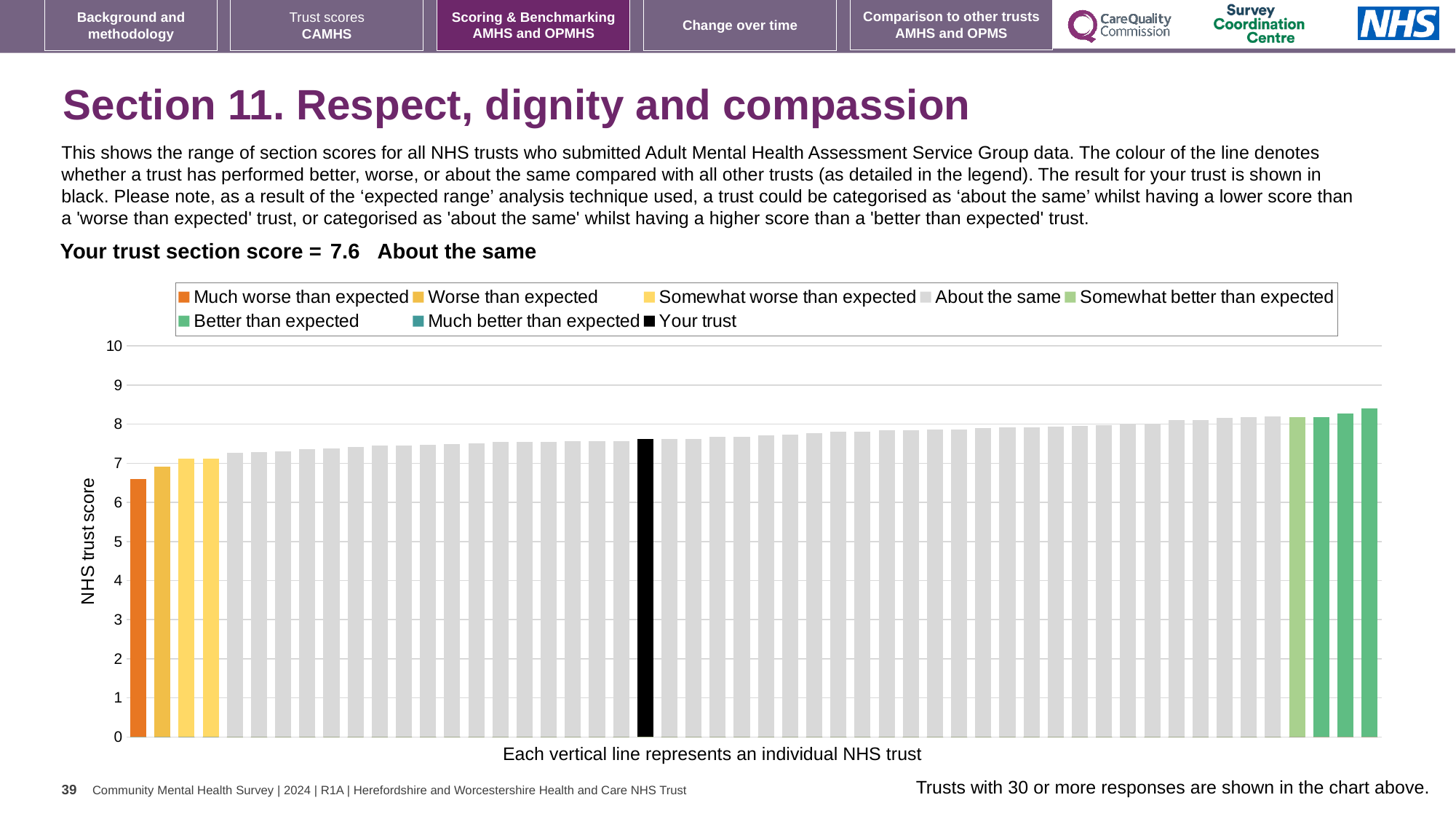
Is the value of the leftmost (orange) bar greater or less than 7? less Is the value of the rightmost bar greater or less than 8? greater Which legend category does the highest bar belong to? Better than expected Do the bar values rise or fall from left to right along the x axis? rise Is the value for your trust (the black bar) greater or less than 8? less How many bars are coloured as 'Better than expected'? 3 What kind of chart is shown on the slide? bar chart What is the label on the vertical axis of the chart? NHS trust score How many entries does the chart legend list? 8 Which legend category does the lowest bar belong to? Much worse than expected What is the section score for your trust shown on the slide? 7.6